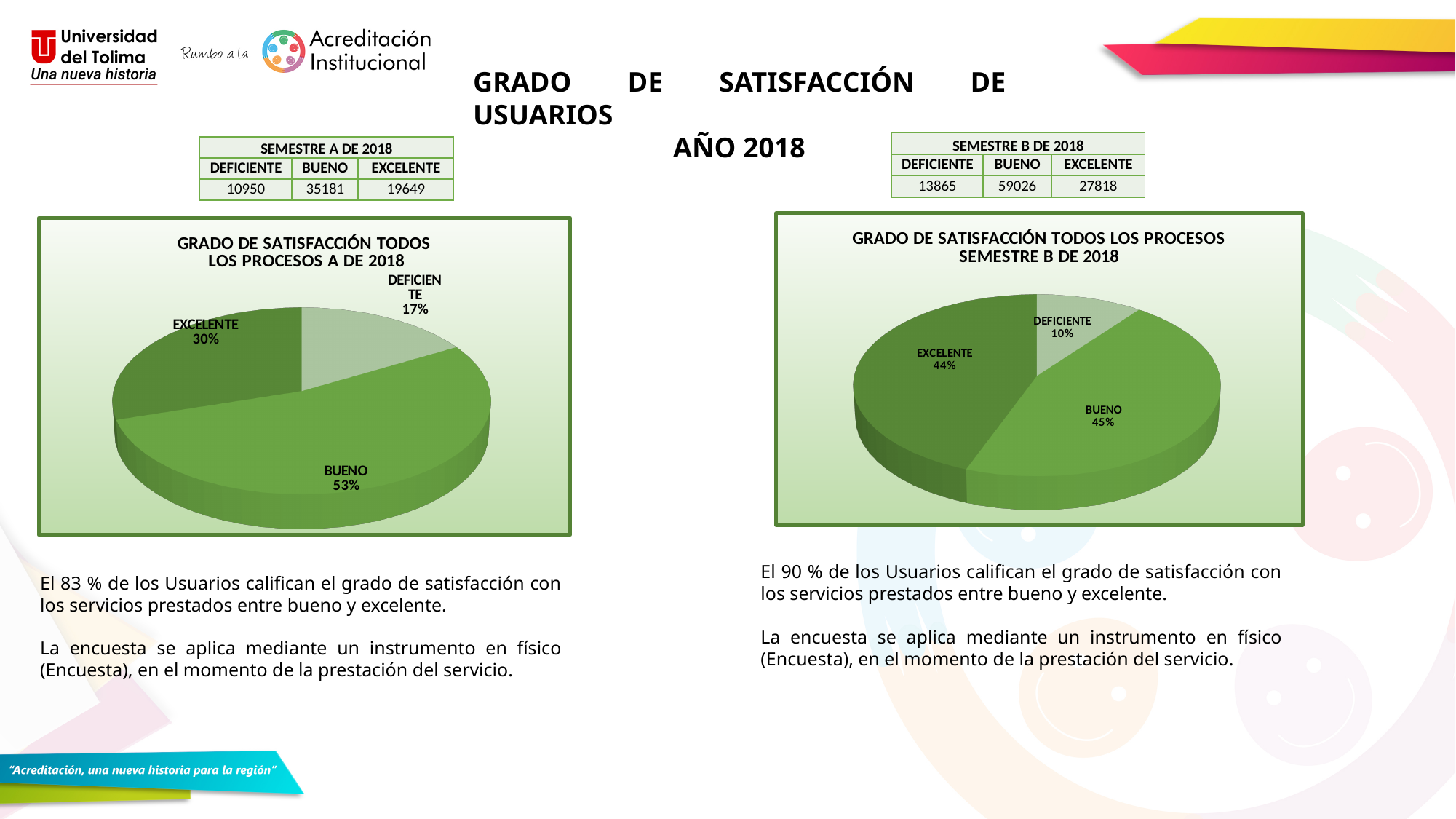
In the left chart (semester A de 2018), which category has the largest slice? BUENO In the left chart (semester A de 2018), what share of the pie is BUENO? 53% How many slices does the right chart (semestre B de 2018) have? 3 In the left chart (semester A de 2018), what share of the pie is EXCELENTE? 30% In the right chart (semestre B de 2018), what share of the pie is EXCELENTE? 44% What kind of chart is the left chart titled 'GRADO DE SATISFACCIÓN TODOS LOS PROCESOS A DE 2018'? Pie chart In the right chart (semestre B de 2018), what is the difference in percentage points between BUENO and DEFICIENTE? 35 In the right chart (semestre B de 2018), which category has the smallest slice? DEFICIENTE In the left chart (semester A de 2018), which category has the smallest slice? DEFICIENTE In the left chart (semester A de 2018), what is the difference in percentage points between BUENO and EXCELENTE? 23